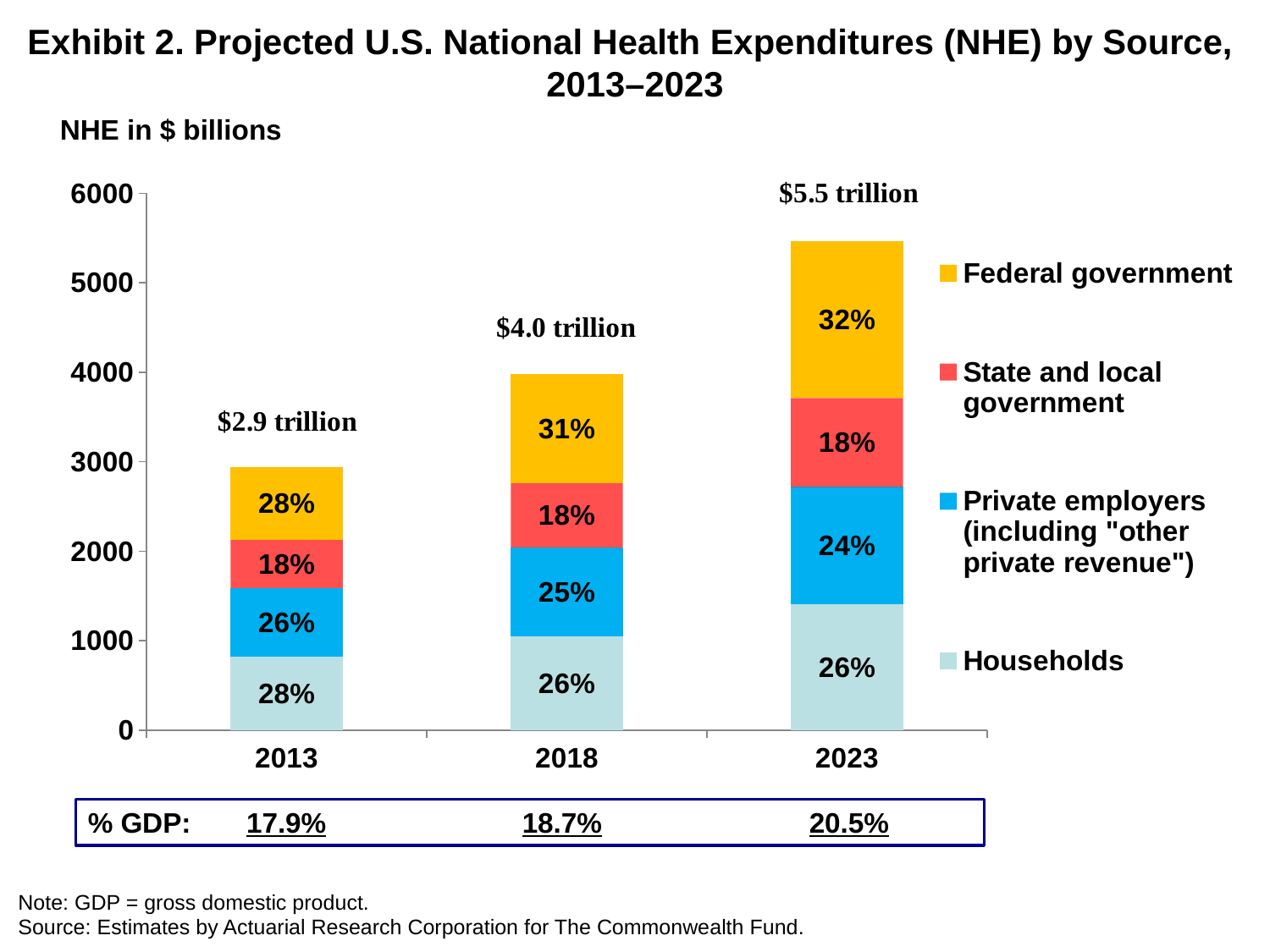
Is the total bar for 2013 greater or less than 3000 on the y axis? less By how many percentage points does the Federal government share in 2023 exceed its share in 2013? 4 percentage points Which year has the highest total projected NHE? 2023 How many years are shown on the x axis of the chart? 3 What is the total projected NHE for 2018? $4.0 trillion Is the Federal government share larger in 2013 or in 2023? 2023 How many series does the legend list? 4 What kind of chart is shown on the slide? Stacked bar chart Does total NHE rise or fall from 2013 to 2023? Rises What share of NHE comes from Households in 2013? 28% What share of NHE is attributed to the Federal government in 2023? 32% What is NHE as a percentage of GDP in 2023? 20.5%